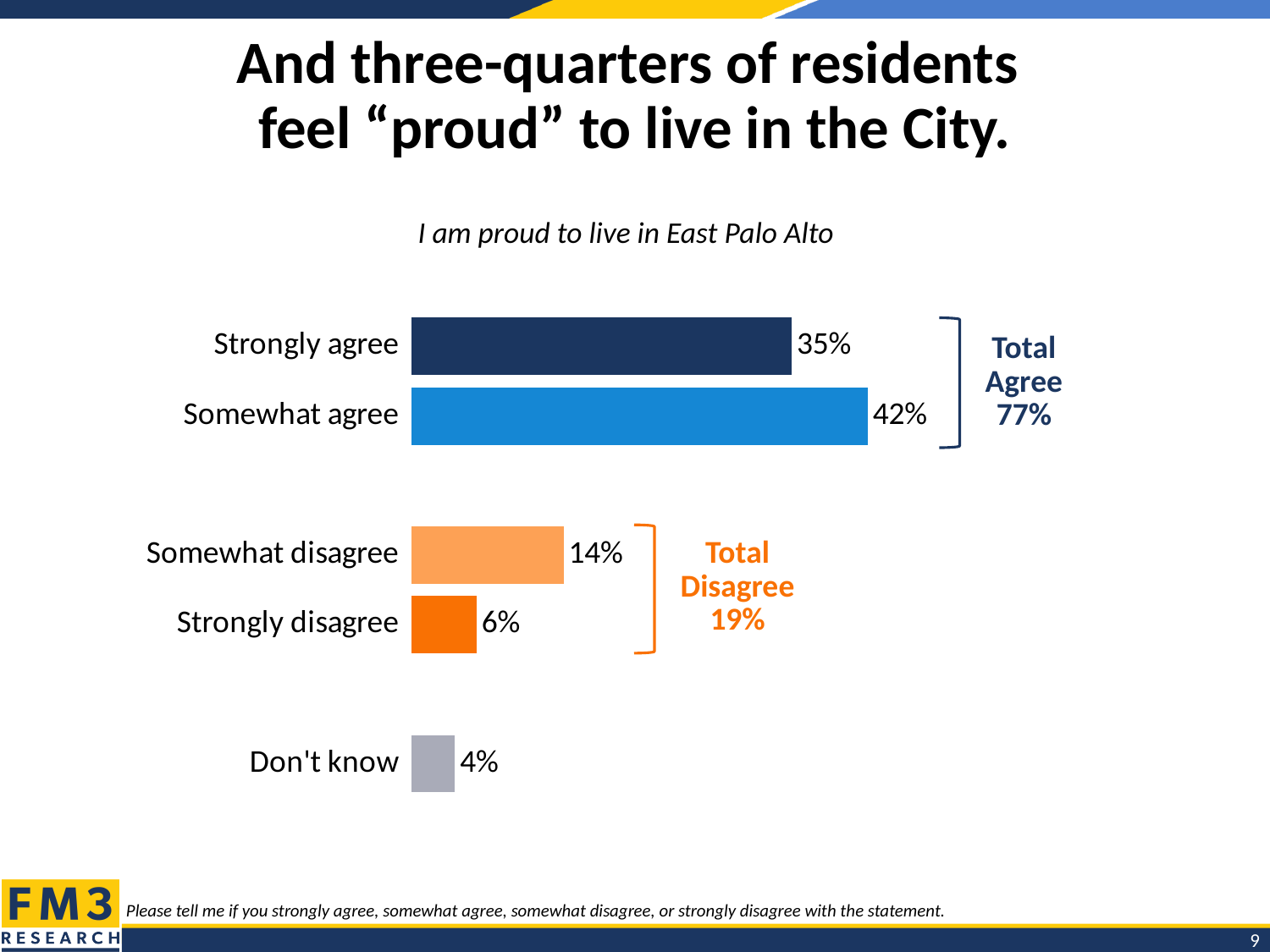
What percentage of respondents strongly agree that they are proud to live in East Palo Alto? 35% What percentage of respondents somewhat agree with the statement? 42% What percentage of respondents somewhat disagree with the statement? 14% What percentage of respondents answered 'Don't know'? 4% Which response category has the highest percentage? Somewhat agree Which is larger, the percentage for 'Somewhat disagree' or for 'Strongly disagree'? Somewhat disagree What is the Total Disagree percentage shown on the chart? 19% Which response category has the lowest percentage? Don't know What is the difference in percentage points between 'Somewhat agree' and 'Strongly agree'? 7 What is the Total Agree percentage shown on the chart? 77% What percentage of respondents strongly disagree with the statement? 6% What type of chart is shown on the slide? Bar chart